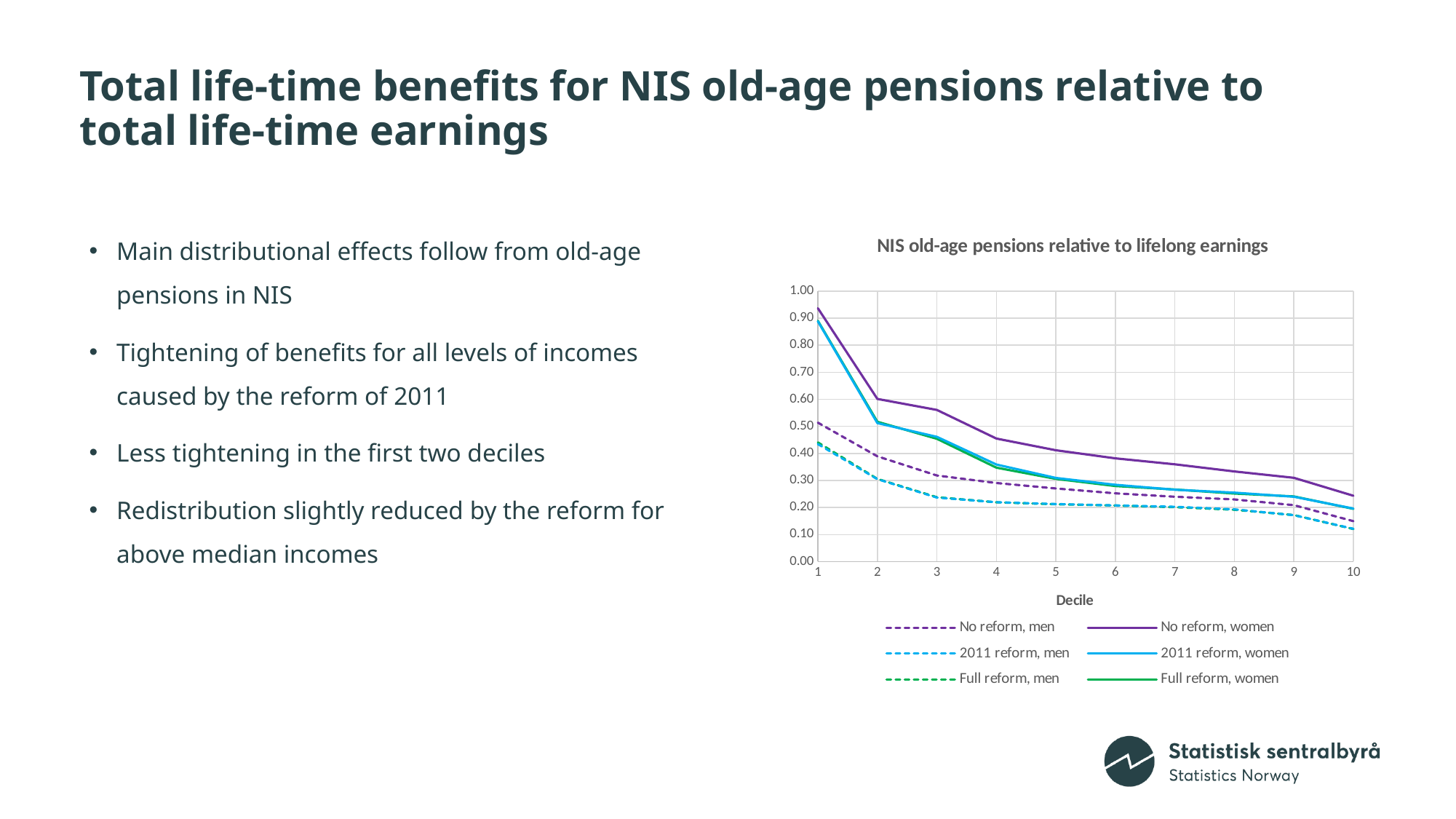
What is the title of the chart? NIS old-age pensions relative to lifelong earnings How many series does the legend of the chart list? 6 Is the value for 'No reform, women' at decile 1 greater or less than 0.80? greater Is the value for 'No reform, men' at decile 1 greater or less than 0.40? greater Which series has the highest value at decile 1? No reform, women What is the label of the x axis of the chart? Decile What kind of chart is shown on the slide? line chart Do the values of the 'No reform, women' series rise or fall as the decile increases? fall How many deciles are plotted along the x axis of the chart? 10 Is the value for '2011 reform, men' at decile 10 greater or less than 0.20? less At decile 1, which is larger: the value for 'No reform, women' or the value for 'No reform, men'? No reform, women